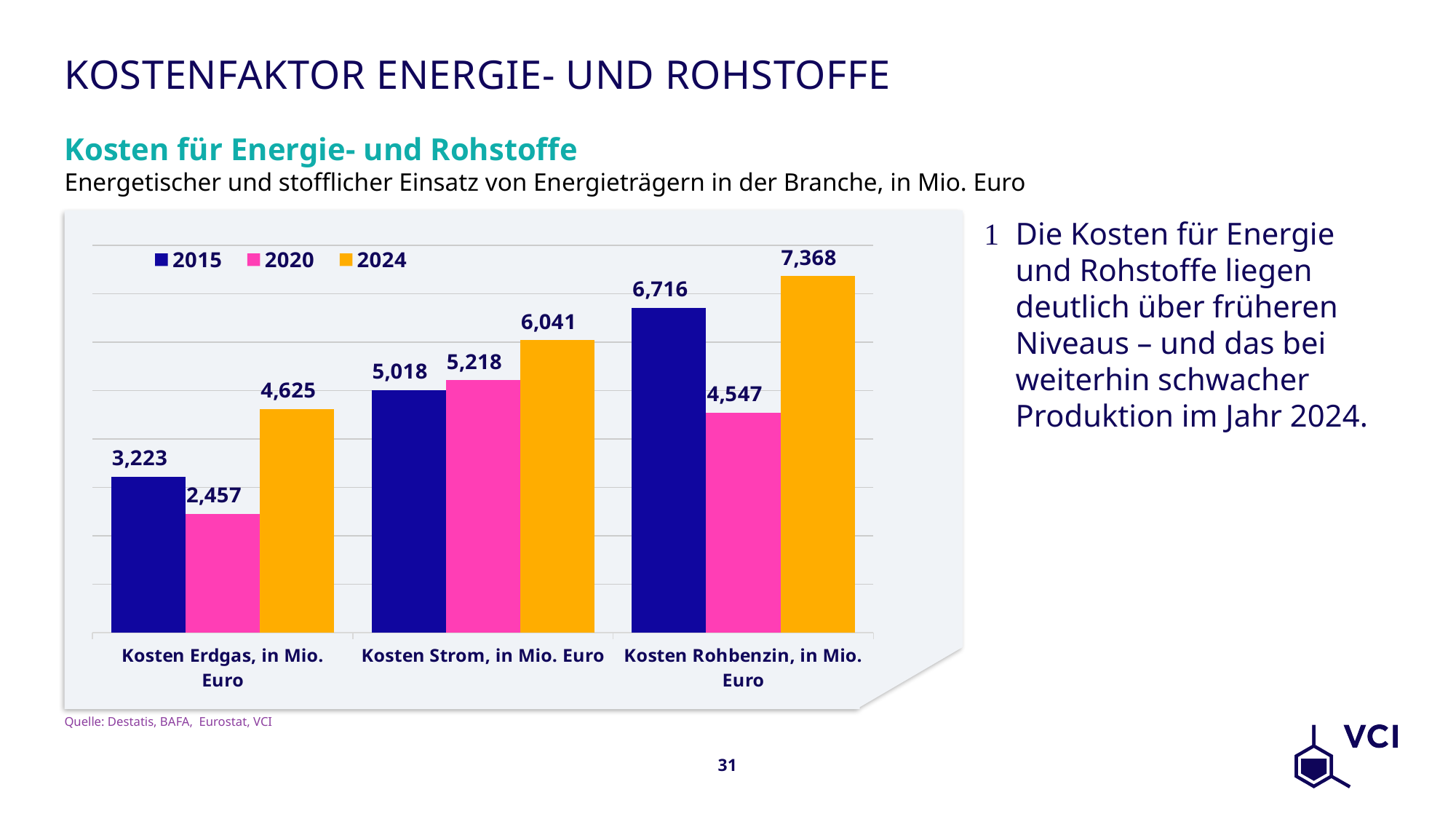
What is the difference between the 2015 and 2020 values for Kosten Erdgas? 766 What is the value for Kosten Rohbenzin in 2020? 4,547 How many series does the legend list? 3 What is the value for Kosten Strom in 2015? 5,018 Which category has the lowest value in the 2020 series? Kosten Erdgas, in Mio. Euro What kind of chart is shown on the slide? Bar chart Which colour represents the 2020 series in the legend? Pink What is the value for Kosten Erdgas in 2024? 4,625 How many categories are shown on the x axis? 3 Which category has the highest value in the 2024 series? Kosten Rohbenzin, in Mio. Euro Which is larger for Kosten Strom: the 2020 value or the 2015 value? 2020 What is the difference between the 2024 and 2015 values for Kosten Rohbenzin? 652